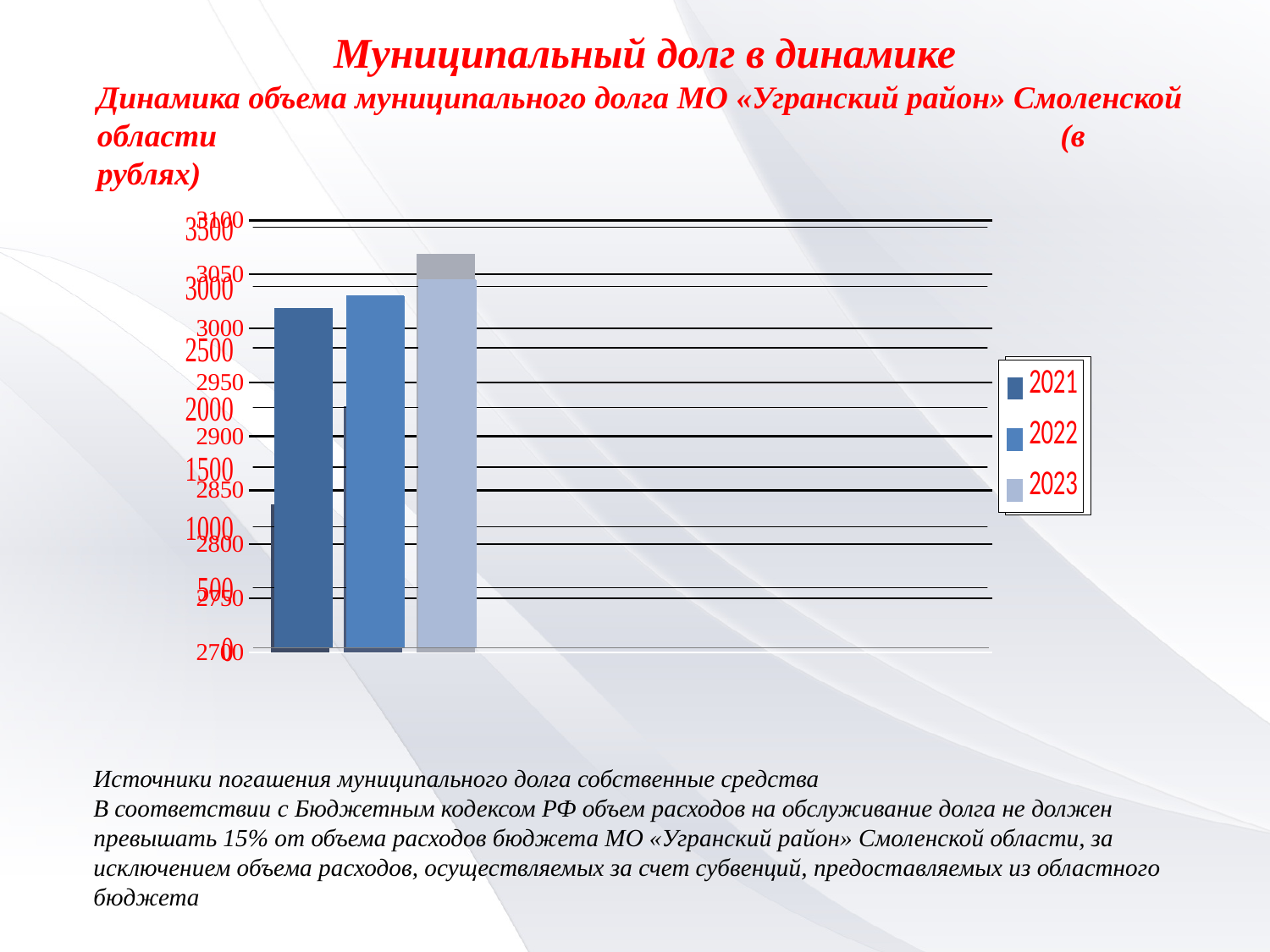
How many bars are plotted in the chart? 3 Is the bar for 2022 taller or shorter than the bar for 2023? shorter Do the bar heights rise or fall from 2021 to 2023? rise Which year has the shortest bar in the chart? 2021 Is the bar for 2023 taller or shorter than the bar for 2021? taller What are the three entries listed in the chart legend? 2021, 2022, 2023 Which year has the tallest bar in the chart? 2023 What is the main title at the top of the slide? Муниципальный долг в динамике How many series does the legend list? 3 What kind of chart is shown on the slide? bar chart